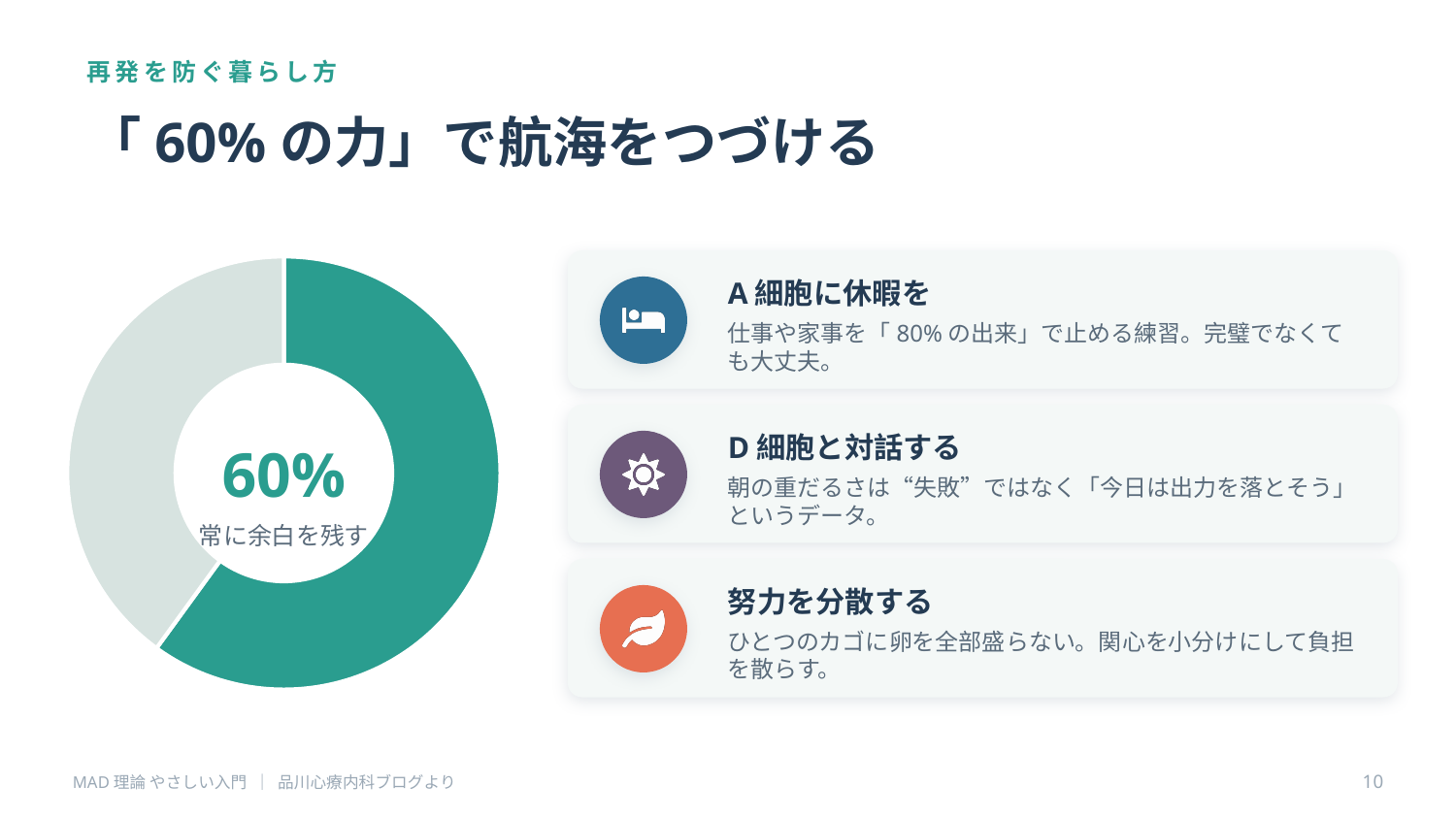
What kind of chart is shown on the left of the slide? Donut (pie) chart Which slice of the donut chart is larger, the green one or the grey one? The green one What is the main title of the slide above the donut chart? 「60% の力」で航海をつづける How many slices does the donut chart have? 2 What percentage is printed in the centre of the donut chart? 60% What share of the donut chart does the green (teal) slice represent? 60% What text is written below the percentage in the centre of the donut chart? 常に余白を残す